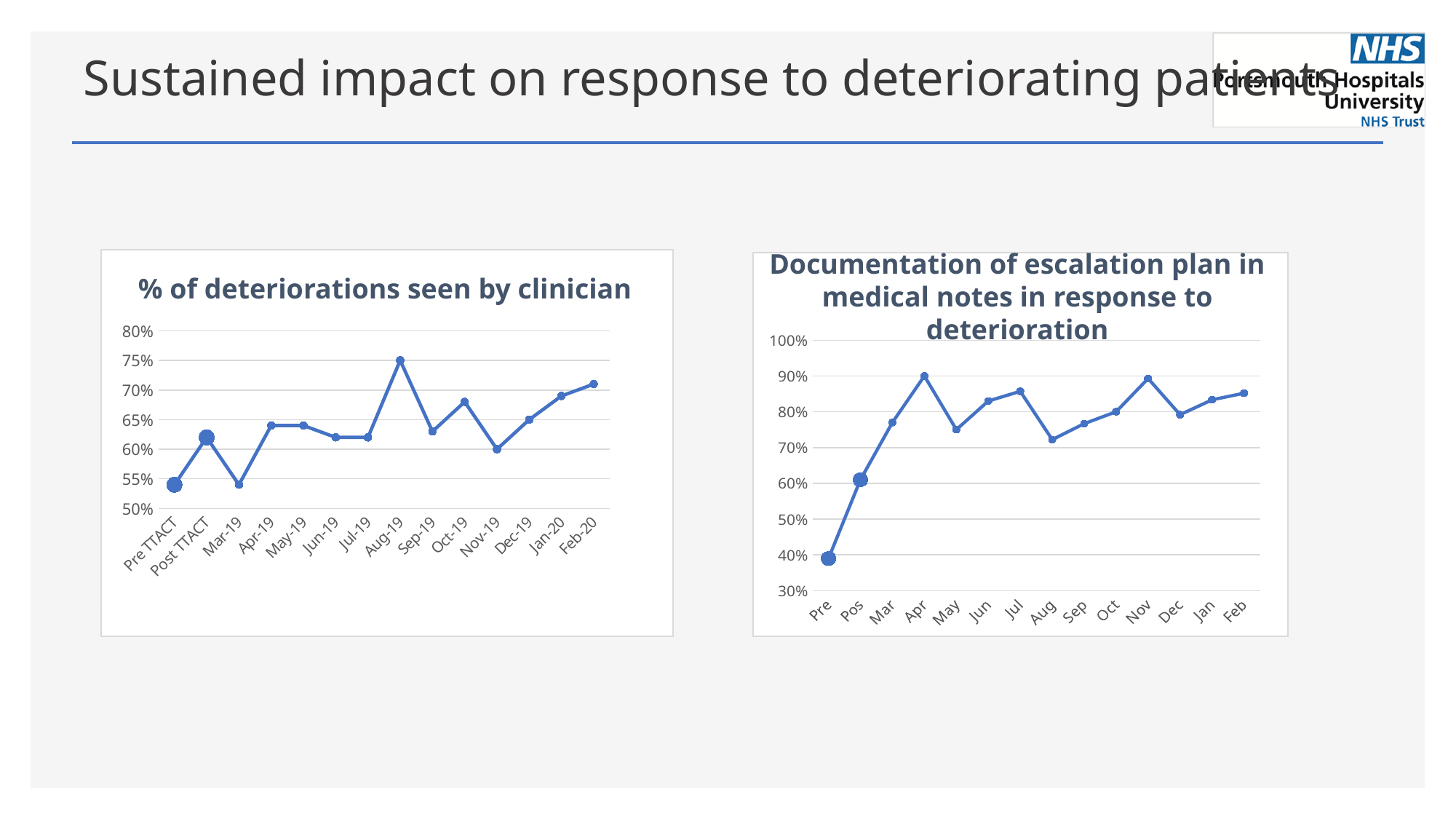
In the '% of deteriorations seen by clinician' chart, which category has the highest value? Aug-19 In the '% of deteriorations seen by clinician' chart, is the value for Oct-19 greater or less than 65%? greater In the 'Documentation of escalation plan in medical notes in response to deterioration' chart, what is the value for Apr? 90% In the 'Documentation of escalation plan in medical notes in response to deterioration' chart, which is larger, the value for Apr or the value for May? Apr In the 'Documentation of escalation plan in medical notes in response to deterioration' chart, which category has the lowest value? Pre How many categories are plotted on the x axis of the '% of deteriorations seen by clinician' chart? 14 What type of chart is the '% of deteriorations seen by clinician' chart? line chart In the 'Documentation of escalation plan in medical notes in response to deterioration' chart, do the values overall rise or fall from Pre to Feb? rise In the '% of deteriorations seen by clinician' chart, what is the value for Aug-19? 75% In the '% of deteriorations seen by clinician' chart, what is the value for Nov-19? 60%